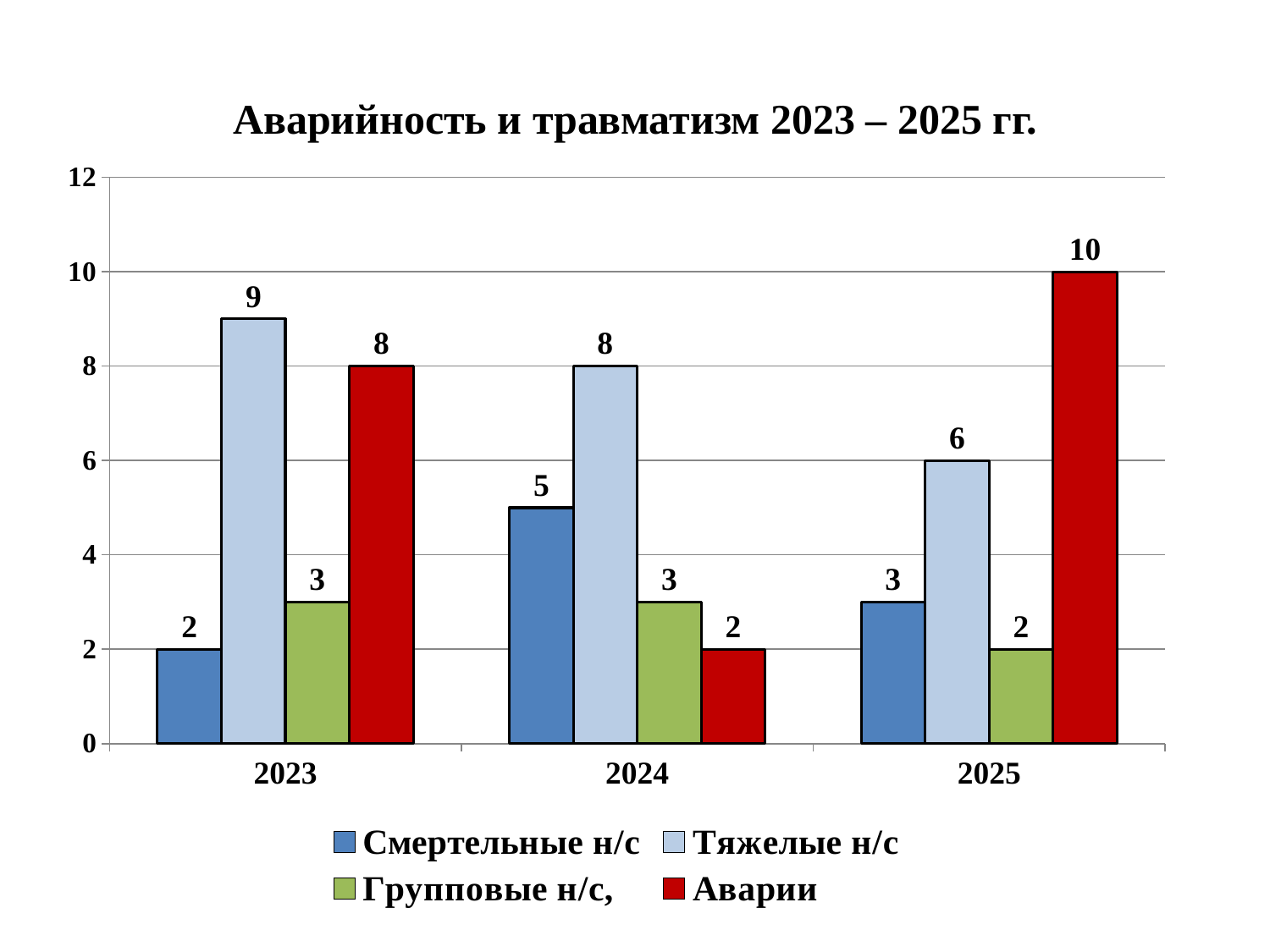
What is the value for Аварии in 2025? 10 In which year is the value for Аварии the lowest? 2024 Does the value for Тяжелые н/с rise or fall from 2023 to 2025? fall What is the difference between Аварии in 2025 and Аварии in 2024? 8 In which year is the value for Тяжелые н/с the highest? 2023 Which is larger in 2023: Тяжелые н/с or Аварии? Тяжелые н/с What kind of chart is this? bar chart What is the title of the chart? Аварийность и травматизм 2023 – 2025 гг. What is the value for Тяжелые н/с in 2023? 9 What is the value for Смертельные н/с in 2024? 5 How many years are shown on the x axis? 3 How many series does the legend list? 4